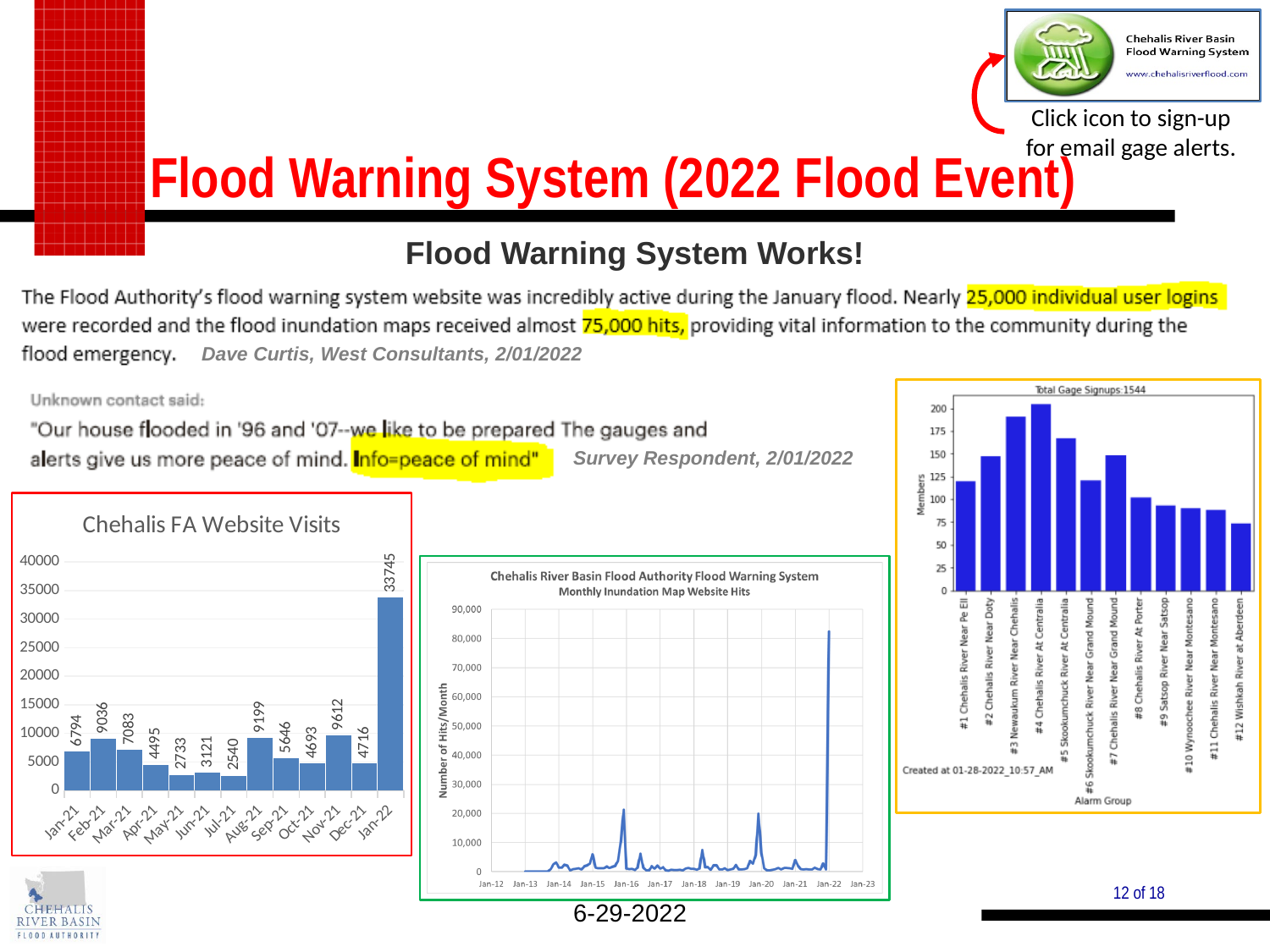
In the Chehalis FA Website Visits chart, which month has the lowest number of visits? Jul-21 In the Total Gage Signups chart, is the value for #9 Satsop River Near Satsop greater or less than 100? less How many months are shown in the Chehalis FA Website Visits chart? 13 In the Total Gage Signups chart, which alarm group has the fewest members? #12 Wishkah River at Aberdeen What kind of chart is the Monthly Inundation Map Website Hits chart in the middle of the slide? line chart In the Total Gage Signups chart, which alarm group has the most members? #4 Chehalis River At Centralia In the Monthly Inundation Map Website Hits chart, is the peak value near Jan-22 greater or less than 70,000? greater In the Chehalis FA Website Visits chart, what is the value for Jan-22? 33745 In the Chehalis FA Website Visits chart, which month has the highest number of visits? Jan-22 In the Chehalis FA Website Visits chart, which is larger, the value for Feb-21 or the value for Mar-21? Feb-21 In the Chehalis FA Website Visits chart, what is the difference between the values for Nov-21 and Dec-21? 4896 In the Chehalis FA Website Visits chart, what is the value for Aug-21? 9199